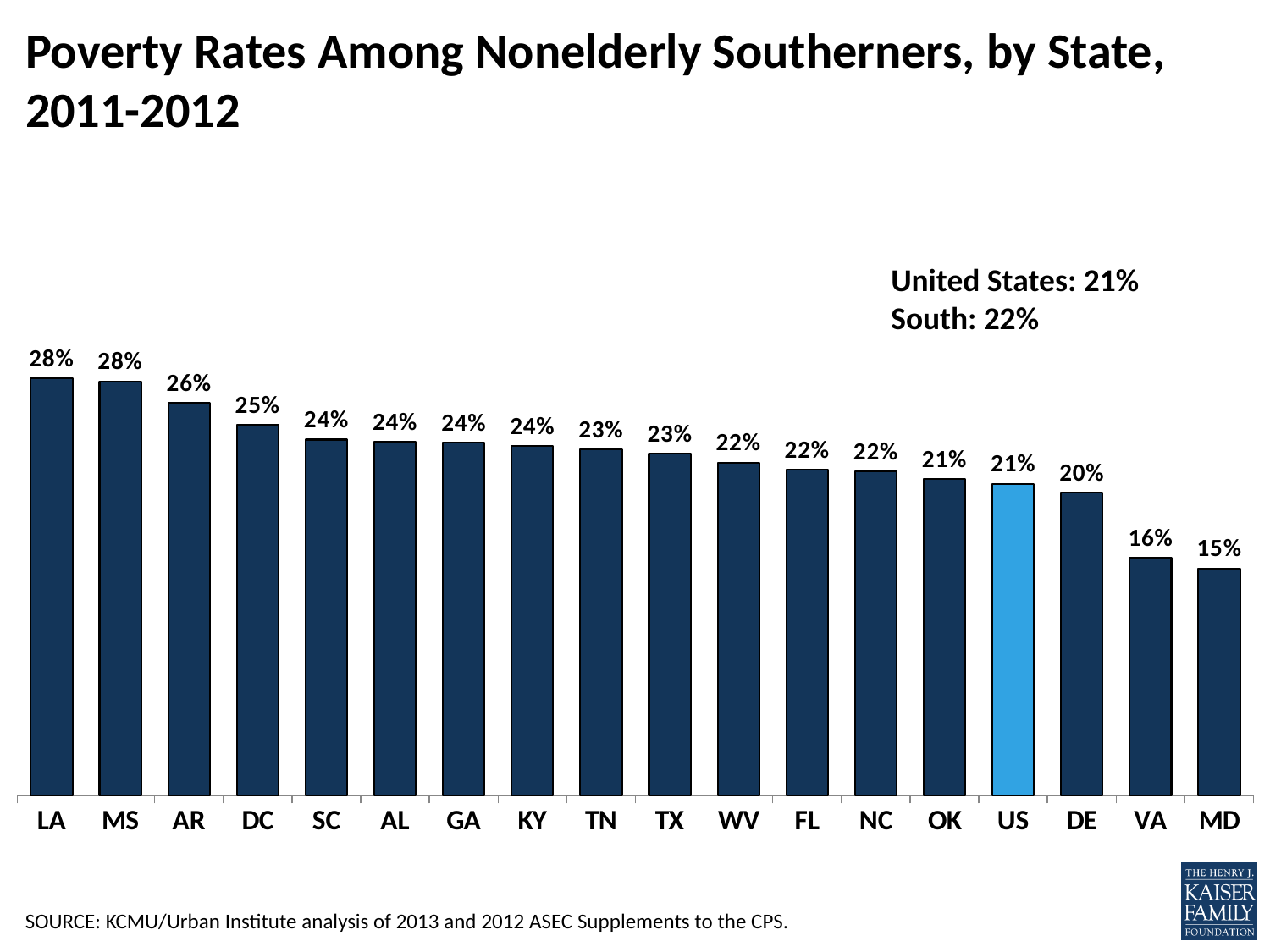
What is the poverty rate shown for Louisiana (LA)? 28% How many bars are plotted on the chart? 18 What is the poverty rate shown for Texas (TX)? 23% What is the poverty rate shown for Virginia (VA)? 16% What kind of chart is shown on the slide? Bar chart Which bar on the chart is shown in a lighter blue colour than the others? US Which has a higher poverty rate, VA or OK? OK Which state has the lowest poverty rate on the chart? MD What is the difference between the poverty rates for Louisiana (LA) and Delaware (DE)? 8 percentage points What is the poverty rate shown for the US bar? 21% Which has a higher poverty rate, DC or FL? DC What is the difference between the poverty rates for Arkansas (AR) and Maryland (MD)? 11 percentage points